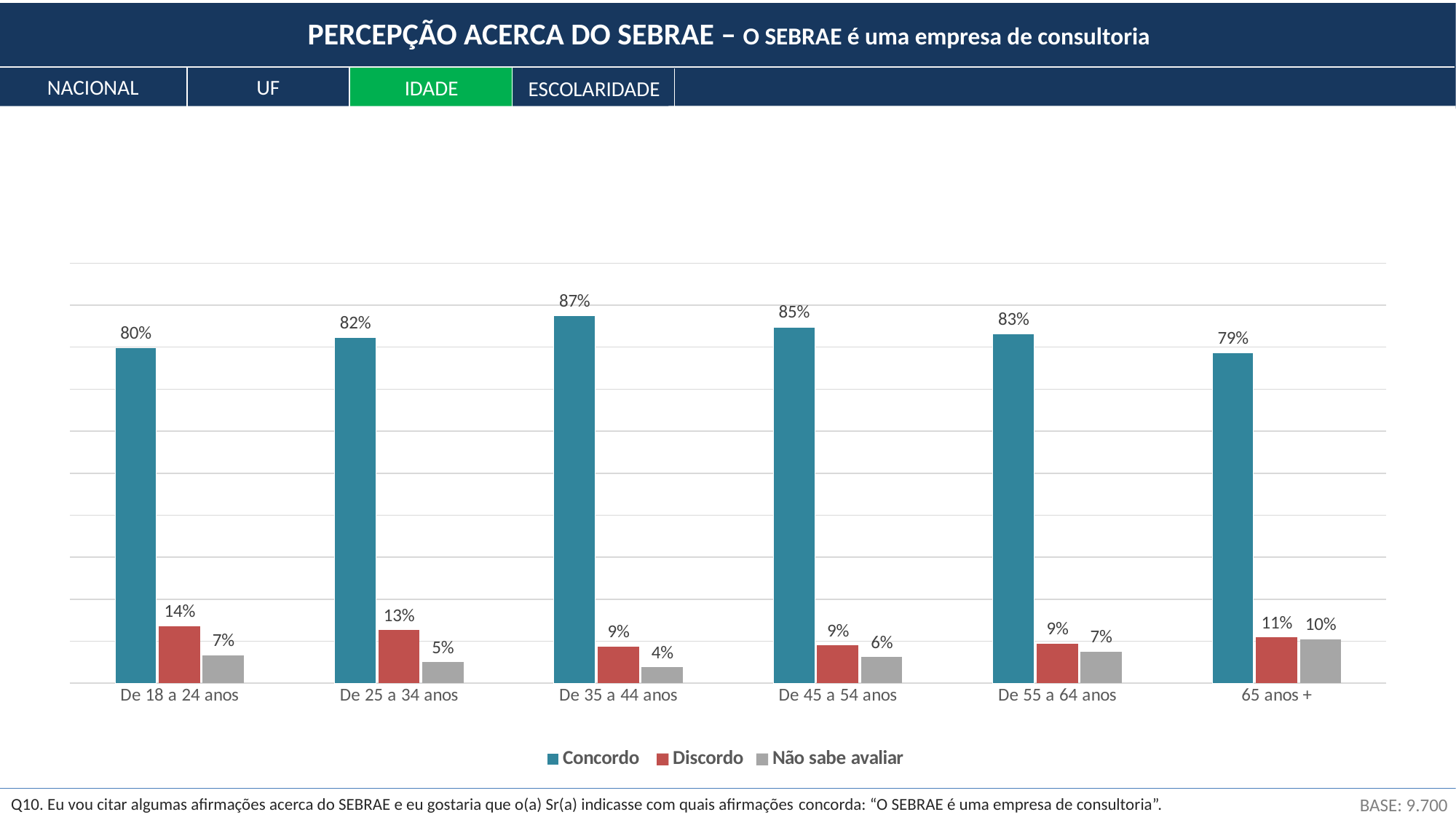
Which age group has the highest Concordo value? De 35 a 44 anos What is the difference between the Concordo values for De 35 a 44 anos and 65 anos +? 8% Which tab is highlighted in green above the chart? IDADE What kind of chart is shown on the slide? Bar chart What is the Concordo value for De 35 a 44 anos? 87% What is the Não sabe avaliar value for 65 anos +? 10% Which age group has the lowest Concordo value? 65 anos + How many series does the legend list? 3 How many age groups are shown on the x axis? 6 Which age group has the lowest Não sabe avaliar value? De 35 a 44 anos Which is larger, the Discordo value for De 25 a 34 anos or for De 55 a 64 anos? De 25 a 34 anos What is the Discordo value for De 18 a 24 anos? 14%